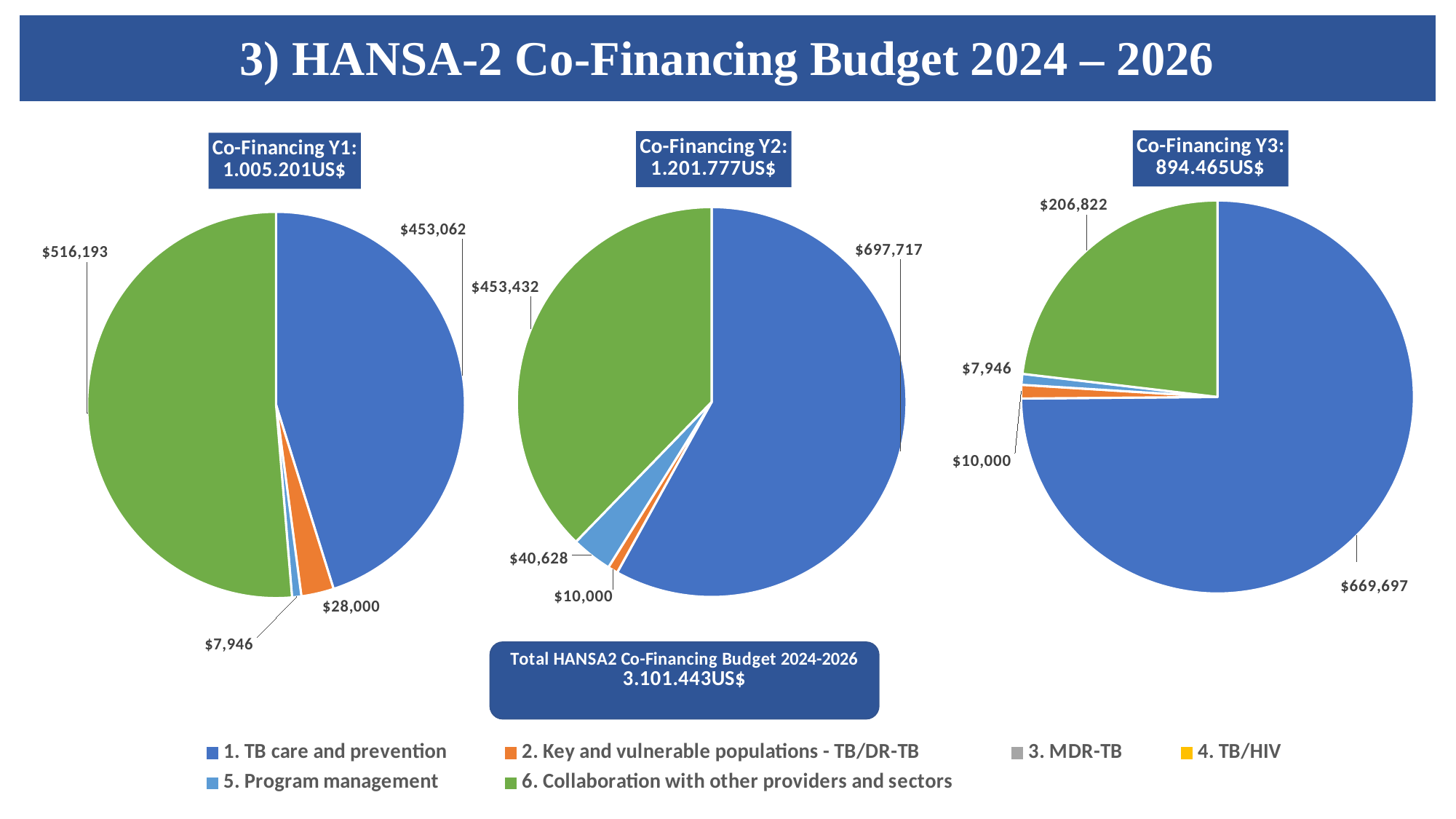
In the Co-Financing Y2 pie chart, what is the value for 2. Key and vulnerable populations - TB/DR-TB? $10,000 In the Co-Financing Y3 pie chart, what is the value for 5. Program management? $7,946 In the Co-Financing Y1 pie chart, what is the difference between 6. Collaboration with other providers and sectors and 1. TB care and prevention? $63,131 In the Co-Financing Y2 pie chart, what is the value for 1. TB care and prevention? $697,717 In the Co-Financing Y2 pie chart, what is the difference between 1. TB care and prevention and 6. Collaboration with other providers and sectors? $244,285 What is the total Co-Financing Y2 budget shown in the chart title? 1.201.777US$ How many categories does the legend list? 6 In the Co-Financing Y1 pie chart, what is the value for 6. Collaboration with other providers and sectors? $516,193 In the Co-Financing Y3 pie chart, which category has the smallest slice? 5. Program management In the Co-Financing Y1 pie chart, which category has the largest slice? 6. Collaboration with other providers and sectors What kind of charts are shown on the slide? Pie charts In the Co-Financing Y3 pie chart, which is larger: 1. TB care and prevention or 6. Collaboration with other providers and sectors? 1. TB care and prevention